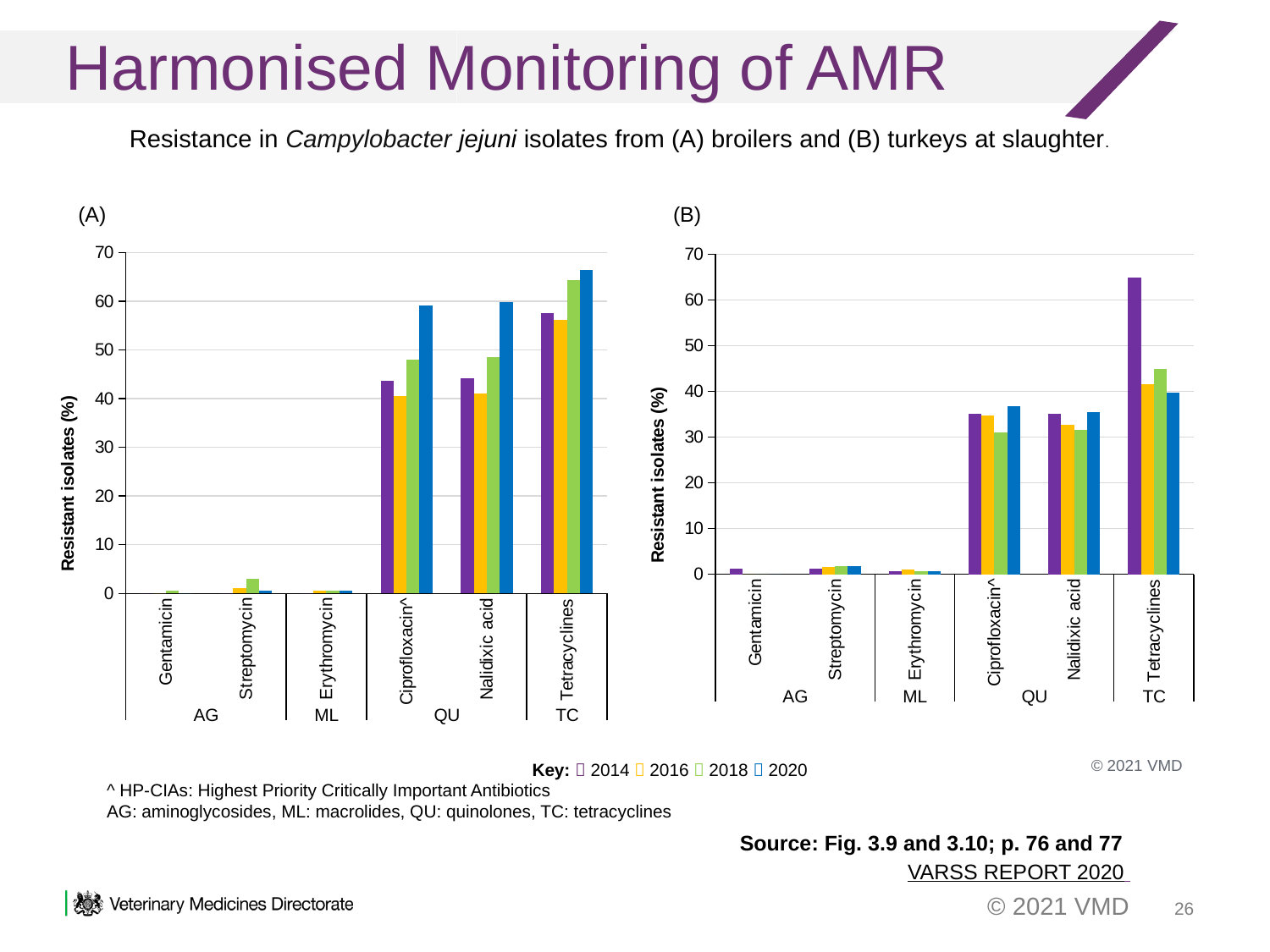
How many antibiotic categories are shown on the x axis of chart (B)? 6 How many series does the key list for the charts? 4 In chart (A), is the 2020 value for Ciprofloxacin^ greater or less than 50? greater What kind of chart is chart (A)? bar chart In chart (A), which antibiotic has the highest 2020 value? Tetracyclines In chart (B), which year has the highest value for Tetracyclines? 2014 In chart (B), is the 2014 value for Tetracyclines larger or smaller than the 2020 value for Tetracyclines? larger In chart (A), is the 2018 value for Gentamicin greater or less than 10? less In chart (B), is the 2020 value for Ciprofloxacin^ greater or less than 20? greater In chart (A), which antibiotic has the lowest resistance values overall? Gentamicin What is the y-axis label on chart (A)? Resistant isolates (%)